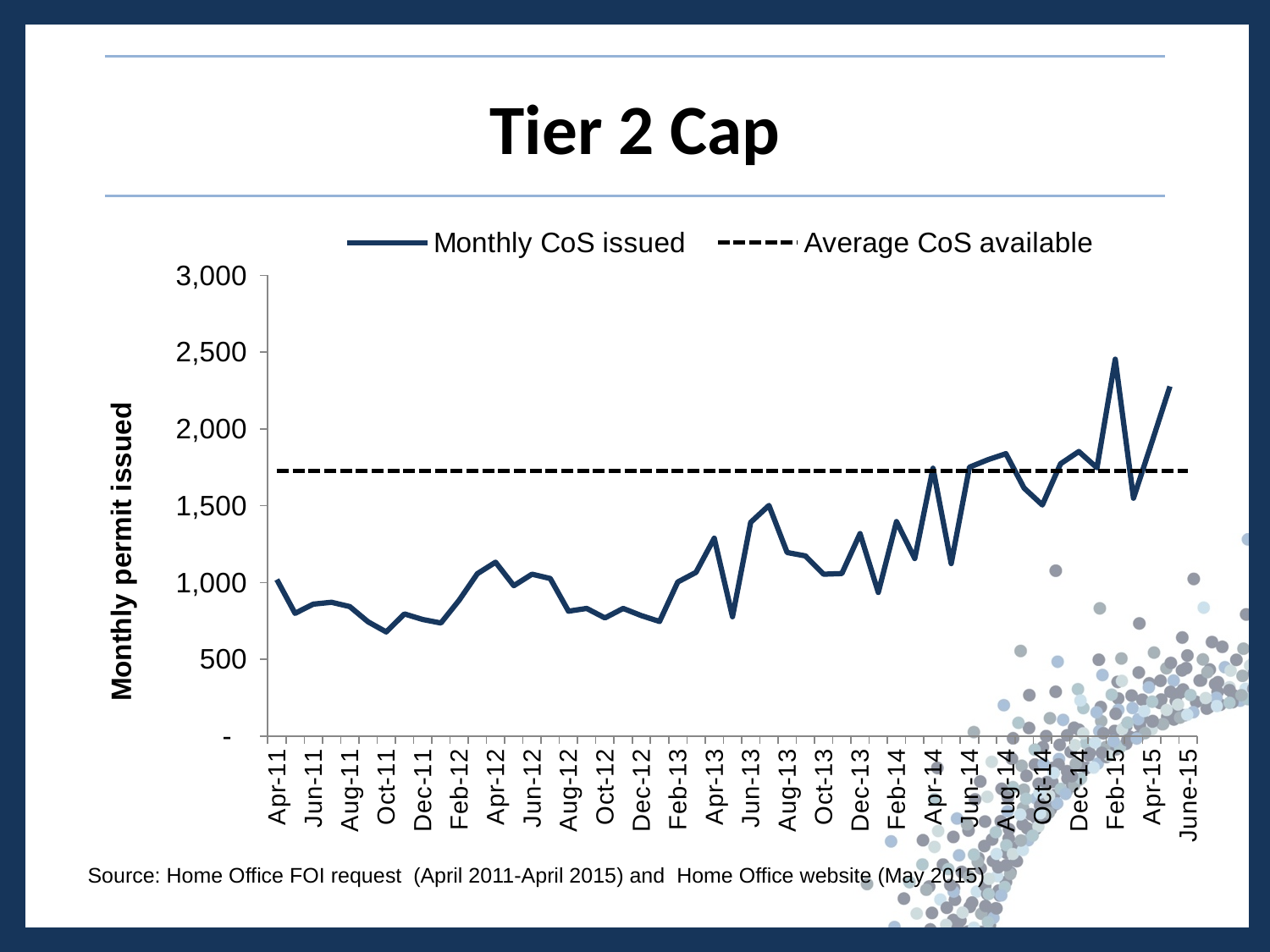
Is the Monthly CoS issued value for Feb-15 greater or less than 2,000? greater Is the Average CoS available line greater or less than 1,500? greater Is the Monthly CoS issued value for Apr-13 greater or less than 1,500? less How many series does the legend list? 2 What is the label on the vertical axis? Monthly permit issued Overall, does the Monthly CoS issued line rise or fall from Apr-11 to Apr-15? rise Which is larger, the Monthly CoS issued value for Feb-15 or for Apr-11? Feb-15 What kind of chart is shown on the slide? Line chart What is the title of the chart? Tier 2 Cap In which month does the Monthly CoS issued line reach its highest value? Feb-15